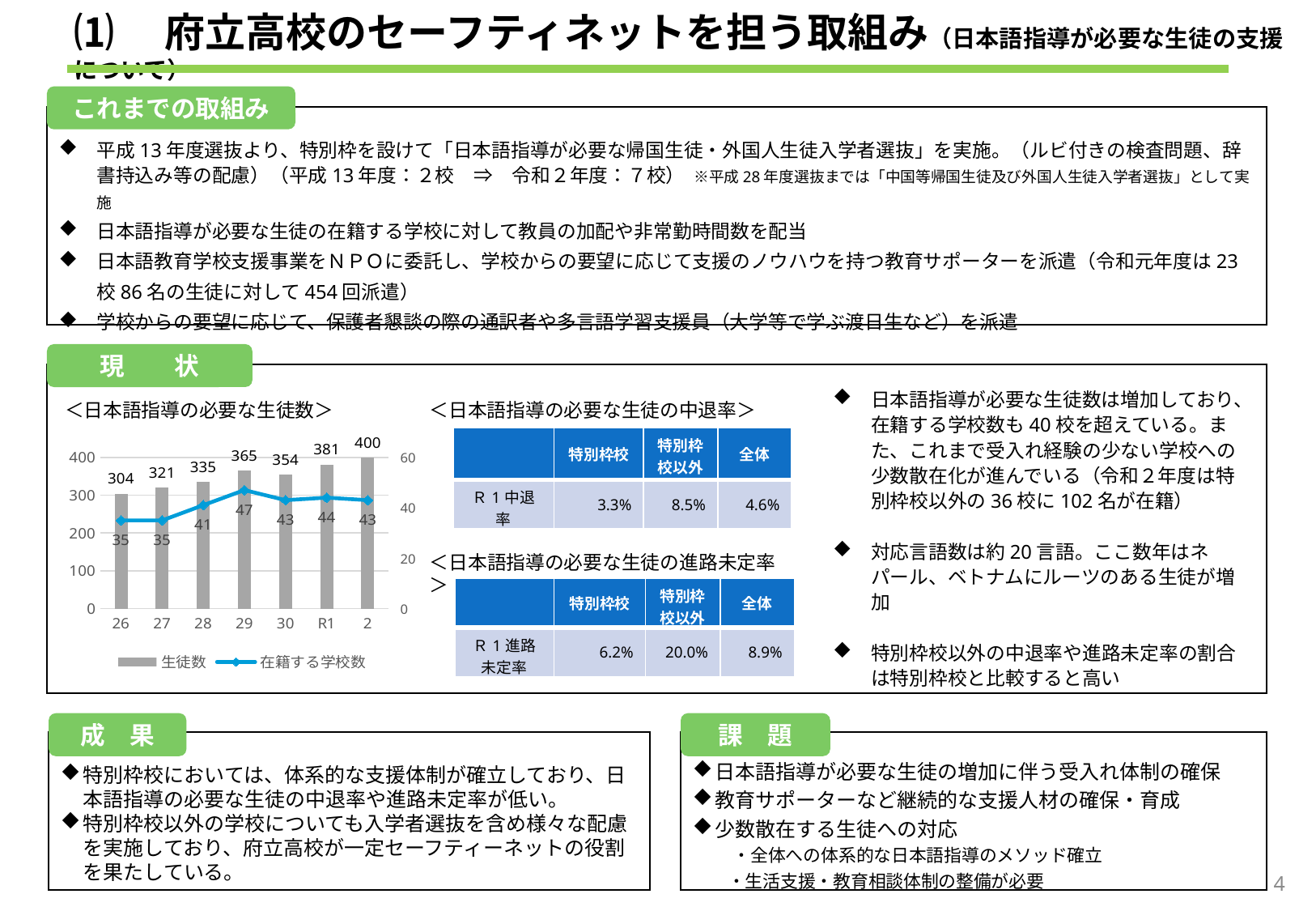
In the chart titled ＜日本語指導の必要な生徒数＞, what is the value of 生徒数 for 29? 365 In the chart titled ＜日本語指導の必要な生徒数＞, what is the value of 在籍する学校数 for R1? 44 In the chart titled ＜日本語指導の必要な生徒数＞, how many series does the legend list? 2 In the chart titled ＜日本語指導の必要な生徒数＞, which category has the highest 在籍する学校数? 29 In the chart titled ＜日本語指導の必要な生徒数＞, what kind of chart is used to show 生徒数? bar chart In the chart titled ＜日本語指導の必要な生徒数＞, which category has the lowest 生徒数? 26 In the chart titled ＜日本語指導の必要な生徒数＞, which category has the highest 生徒数? 2 In the chart titled ＜日本語指導の必要な生徒数＞, how many categories are shown on the x axis? 7 In the chart titled ＜日本語指導の必要な生徒数＞, which is larger, the 生徒数 for 29 or for 30? 29 In the chart titled ＜日本語指導の必要な生徒数＞, does 生徒数 generally rise or fall from 26 to 2? rise In the chart titled ＜日本語指導の必要な生徒数＞, what is the value of 生徒数 for 26? 304 In the chart titled ＜日本語指導の必要な生徒数＞, what is the difference in 生徒数 between 2 and 26? 96